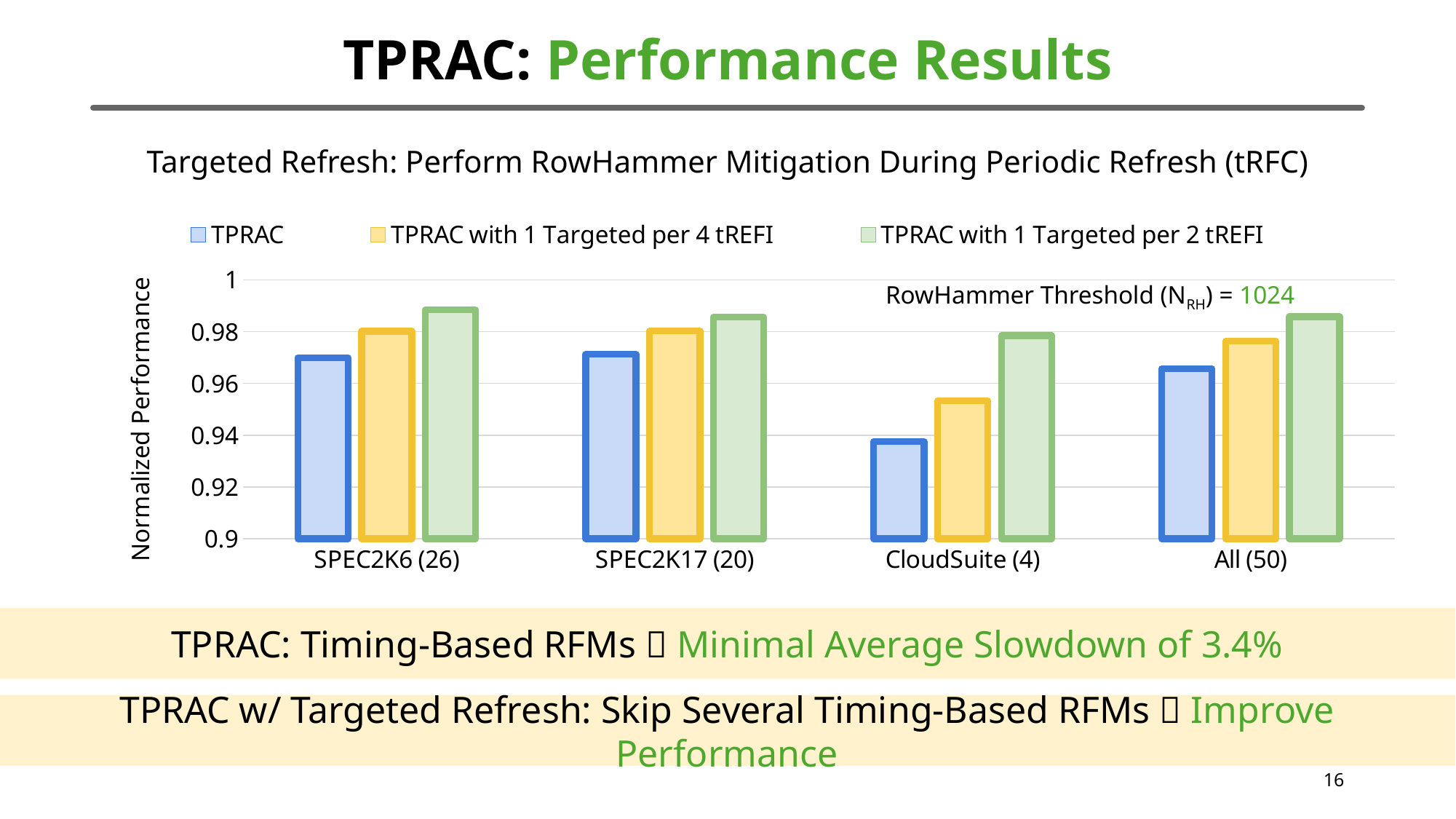
Is the 'TPRAC with 1 Targeted per 4 tREFI' value for CloudSuite (4) greater or less than 0.96? less Is the TPRAC value for SPEC2K6 (26) greater or less than 0.96? greater Is the TPRAC value for CloudSuite (4) greater or less than 0.96? less What kind of chart is shown on the slide? bar chart What RowHammer Threshold (N_RH) is stated on the chart? 1024 Which category has the lowest value for the 'TPRAC with 1 Targeted per 4 tREFI' series? CloudSuite (4) For CloudSuite (4), which is larger: the TPRAC bar or the 'TPRAC with 1 Targeted per 2 tREFI' bar? TPRAC with 1 Targeted per 2 tREFI Which category has the lowest Normalized Performance for the TPRAC series? CloudSuite (4) How many workload categories are shown on the x axis? 4 How many series does the legend list? 3 Which is larger: the TPRAC value for SPEC2K6 (26) or the TPRAC value for CloudSuite (4)? SPEC2K6 (26)